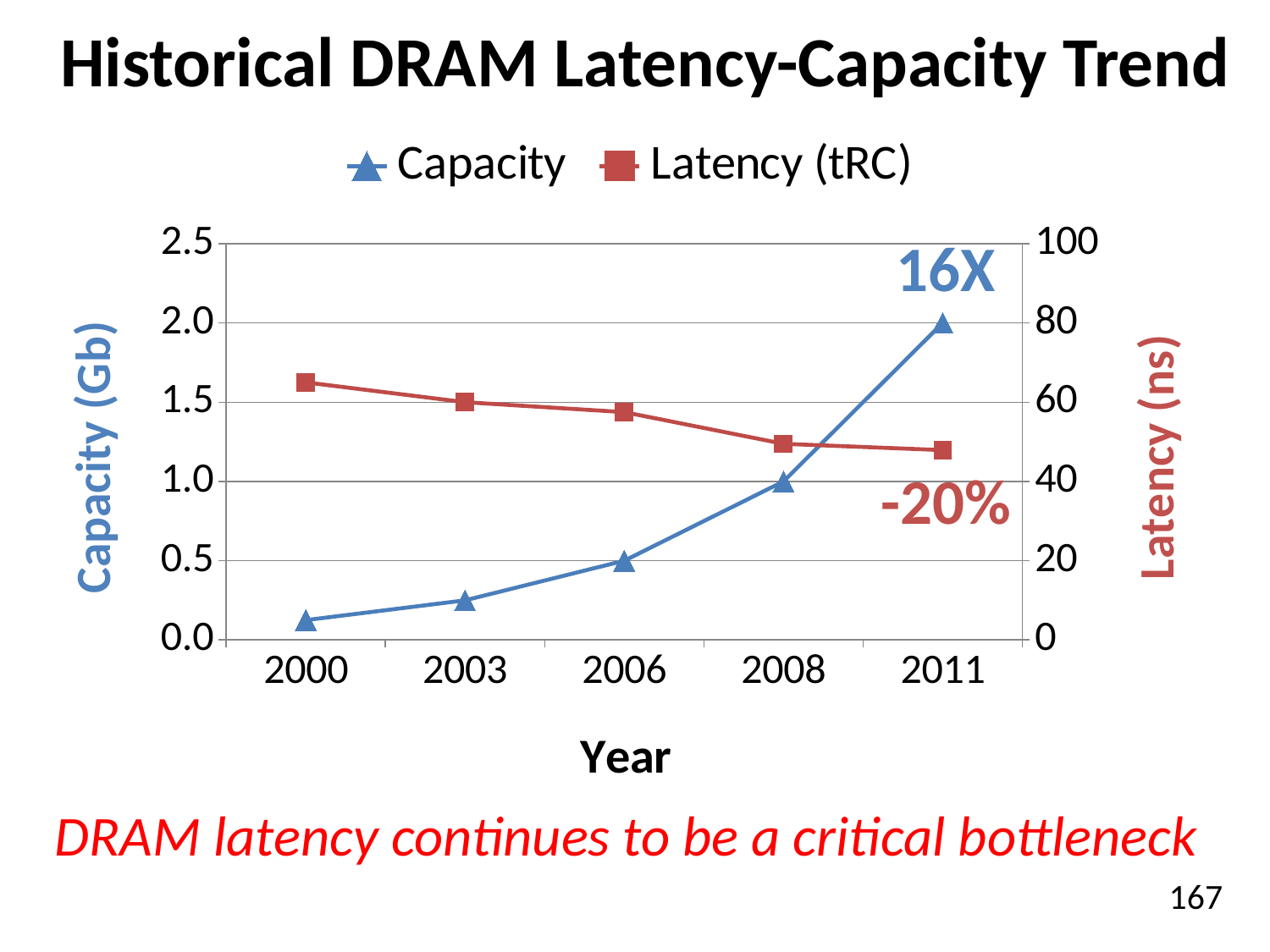
In which year is Capacity highest? 2011 What is the Capacity value for 2008? 1.0 In which year is Latency (tRC) highest? 2000 Is the Capacity value for 2000 greater or less than 0.5? less How many series does the legend list? 2 Is the Latency (tRC) value for 2011 greater or less than 60? less How many years are plotted along the x axis? 5 What is the Capacity value for 2011? 2.0 Does Latency (tRC) rise or fall from 2000 to 2011? fall Is the Latency (tRC) value for 2000 greater or less than 60? greater What kind of chart is shown on the slide? line chart What annotation is printed next to the Capacity line at 2011? 16X